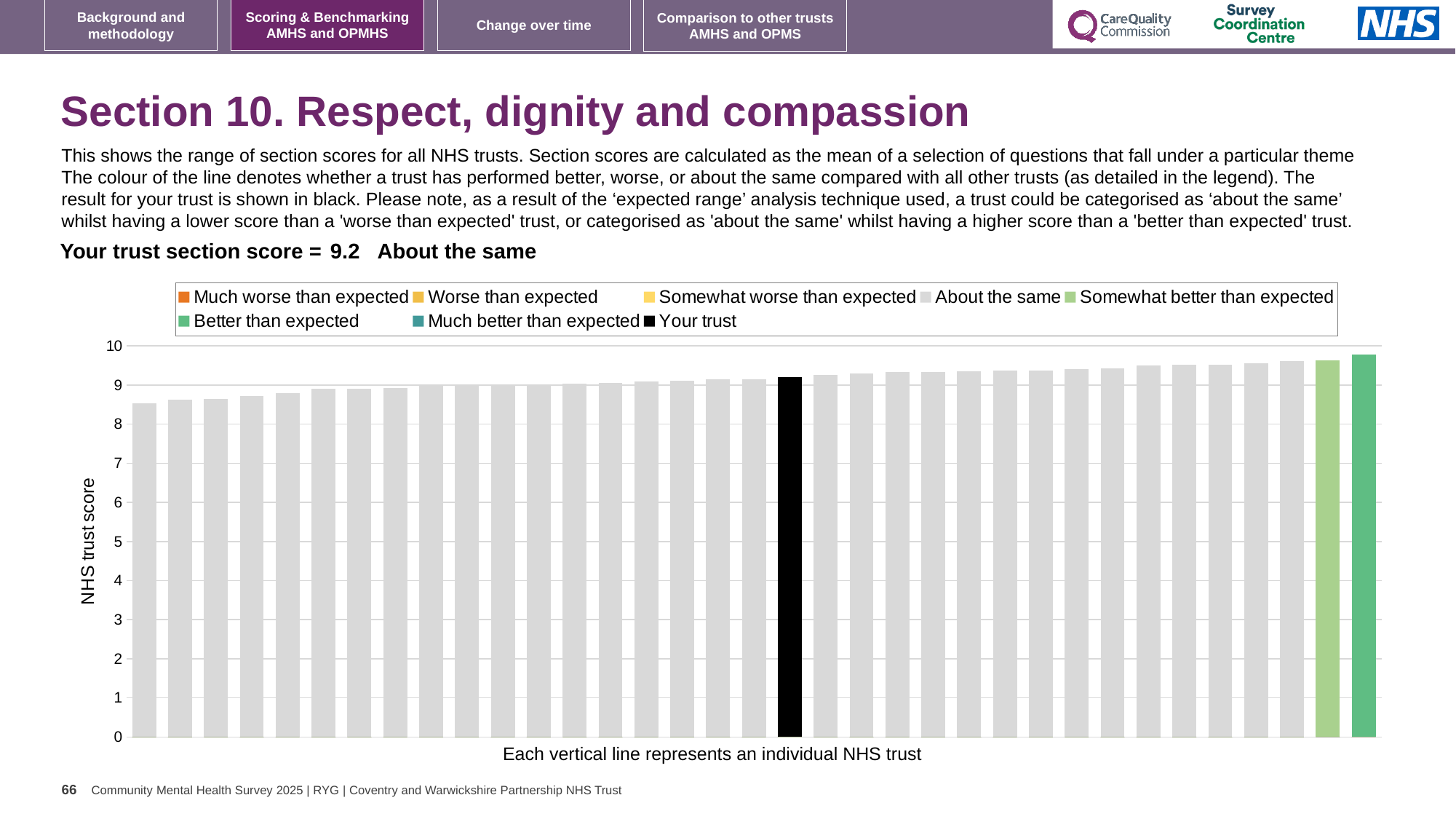
Which category is your trust's section score placed in? About the same What is the section score for your trust shown on the chart? 9.2 Is the value of the leftmost bar greater or less than 8? greater Do the bar values rise or fall from left to right along the x axis? rise What is the label on the y axis of the chart? NHS trust score Is the value of the leftmost bar greater or less than 9? less Is the value for your trust (the black bar) greater or less than 9? greater What kind of chart is shown on the slide? bar chart How many entries does the chart legend list? 8 What colour is the bar representing your trust? black